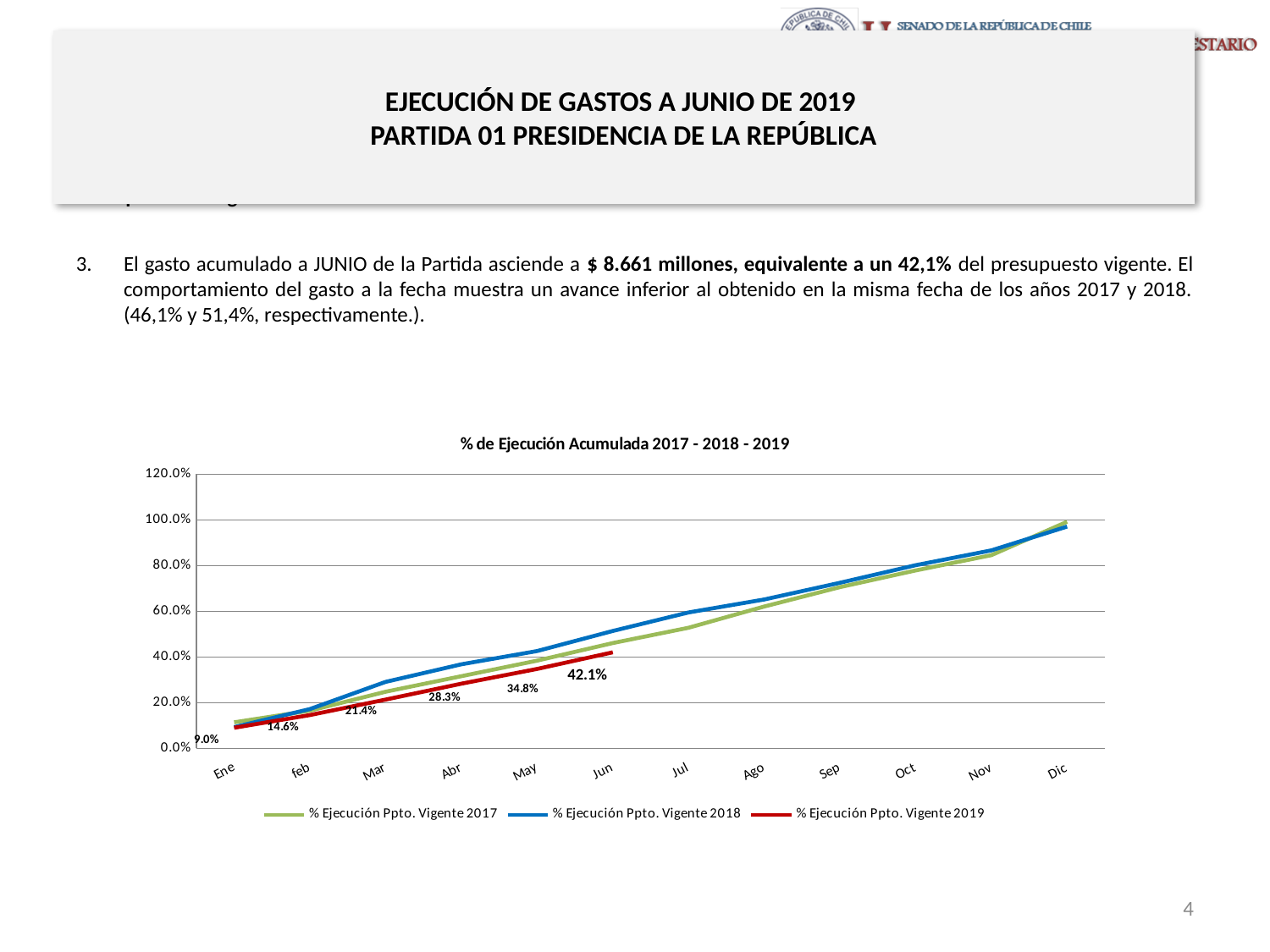
What is the value of % Ejecución Ppto. Vigente 2019 in Jun? 42.1% Which month has the highest labelled value for the 2019 series? Jun What is the value of % Ejecución Ppto. Vigente 2019 in Mar? 21.4% Do the values of the 2018 series rise or fall from Ene to Dic? rise What is the title of the chart? % de Ejecución Acumulada 2017 - 2018 - 2019 What kind of chart is shown on the slide? line chart What is the value of % Ejecución Ppto. Vigente 2019 in Ene? 9.0% In Jun, which series has the larger value: 2018 or 2019? 2018 How many months are shown along the x axis of the chart? 12 Is the value for % Ejecución Ppto. Vigente 2018 in Jun greater or less than 40%? greater What is the difference between the 2019 values for Jun and May? 7.3% How many series does the chart legend list? 3